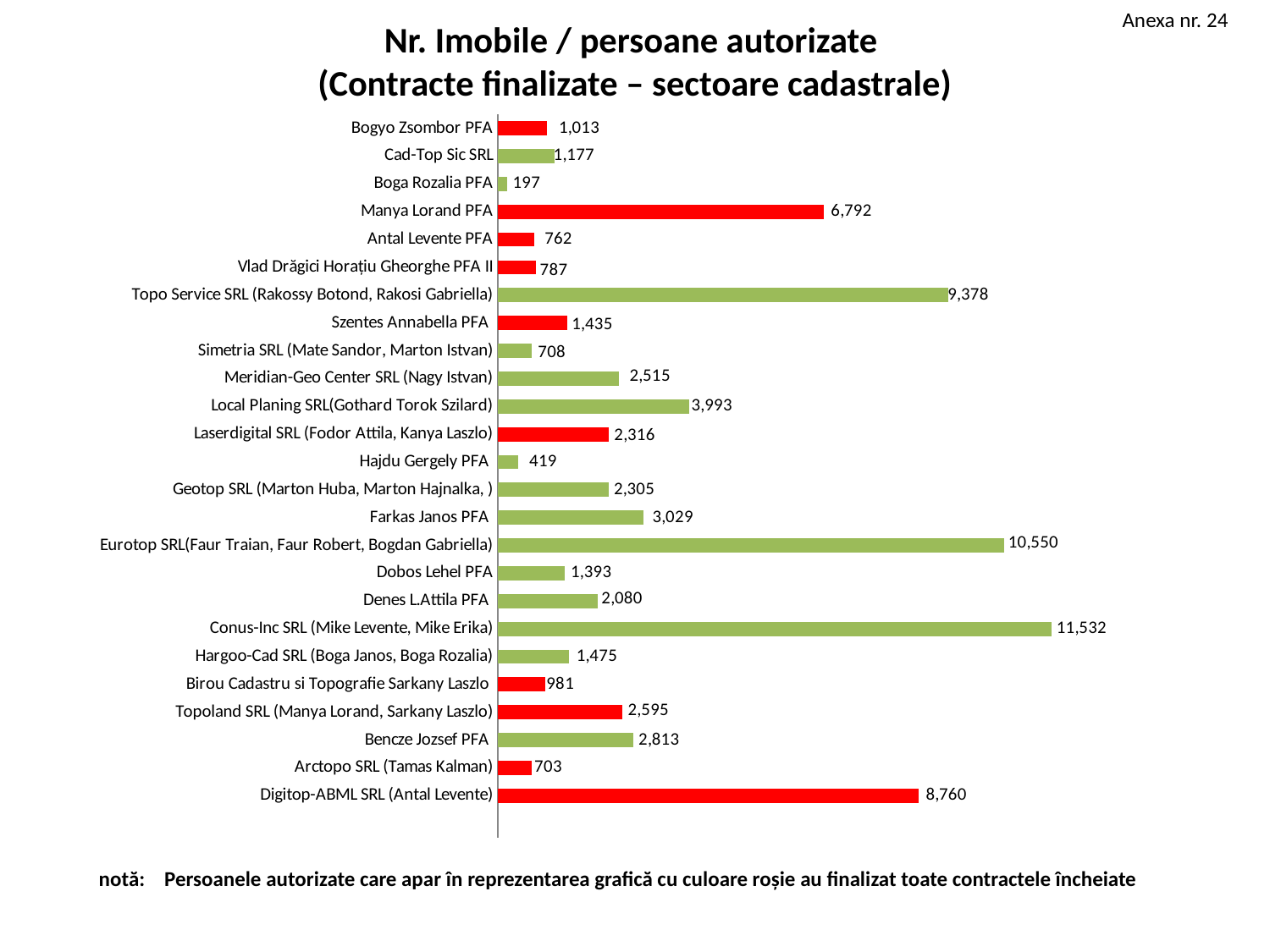
Which category has the highest value? Conus-Inc SRL (Mike Levente, Mike Erika) Which is larger, the value for Local Planing SRL(Gothard Torok Szilard) or the value for Farkas Janos PFA? Local Planing SRL(Gothard Torok Szilard) What is the difference between the values for Conus-Inc SRL (Mike Levente, Mike Erika) and Eurotop SRL(Faur Traian, Faur Robert, Bogdan Gabriella)? 982 What is the value for Eurotop SRL(Faur Traian, Faur Robert, Bogdan Gabriella)? 10,550 What kind of chart is shown on the slide? Bar chart What is the difference between the values for Topo Service SRL (Rakossy Botond, Rakosi Gabriella) and Digitop-ABML SRL (Antal Levente)? 618 What is the value for Manya Lorand PFA? 6,792 What is the value for Hajdu Gergely PFA? 419 According to the note, what does a red bar indicate? The authorized person has finalized all contracts concluded How many categories are shown in the chart? 25 What is the value for Digitop-ABML SRL (Antal Levente)? 8,760 Which category has the lowest value? Boga Rozalia PFA